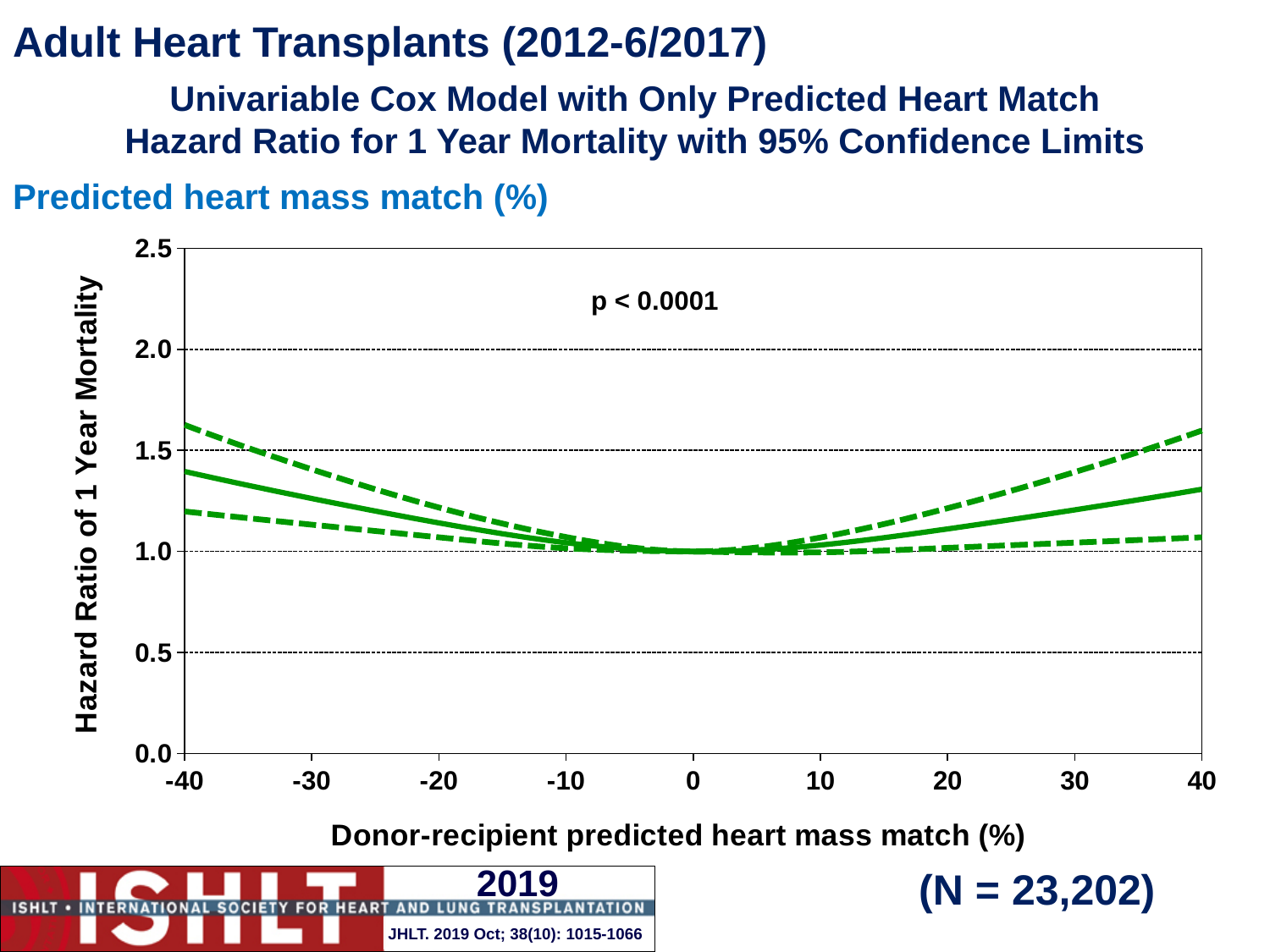
How many tick labels are shown on the x axis? 9 What p-value is printed on the chart? p < 0.0001 Is the hazard ratio (solid line) at a predicted heart mass match of 40% greater or less than 1.0? greater Is the upper 95% confidence limit (upper dashed line) at a predicted heart mass match of -40% greater or less than 1.5? greater What is the sample size (N) shown on the slide? N = 23,202 Does the hazard ratio (solid line) rise or fall as the predicted heart mass match goes from 0% to 40%? rise Is the hazard ratio (solid line) at a predicted heart mass match of -40% greater or less than 1.5? less Does the hazard ratio (solid line) rise or fall as the predicted heart mass match goes from -40% to 0%? fall What is the hazard ratio of 1 year mortality at a donor-recipient predicted heart mass match of 0%? 1.0 How many lines are plotted on the chart? 3 What kind of chart is shown on the slide? line chart